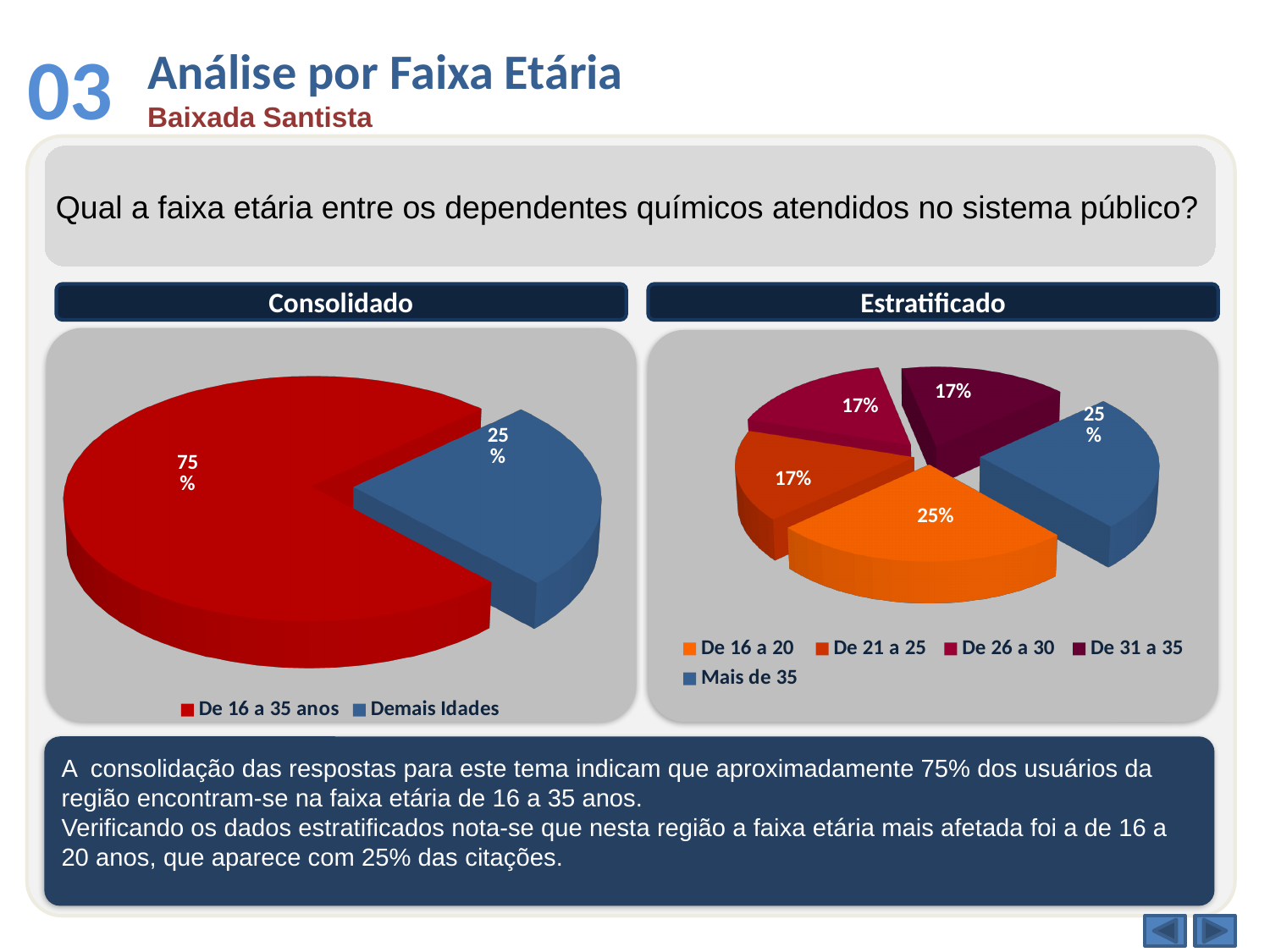
In the Estratificado chart, what colour is the slice for Mais de 35? Blue How many categories does the legend of the Estratificado chart list? 5 In the Consolidado chart, what share is shown for Demais Idades? 25% What kind of chart is the Consolidado chart? Pie chart How many categories does the legend of the Consolidado chart list? 2 In the Consolidado chart, what share is shown for De 16 a 35 anos? 75% In the Consolidado chart, what is the difference between the De 16 a 35 anos slice and the Demais Idades slice? 50% In the Estratificado chart, what share is shown for De 16 a 20? 25% In the Consolidado chart, which category has the largest slice? De 16 a 35 anos In the Estratificado chart, what share is shown for Mais de 35? 25% In the Estratificado chart, which is larger, De 16 a 20 or De 21 a 25? De 16 a 20 In the Estratificado chart, what share is shown for De 26 a 30? 17%